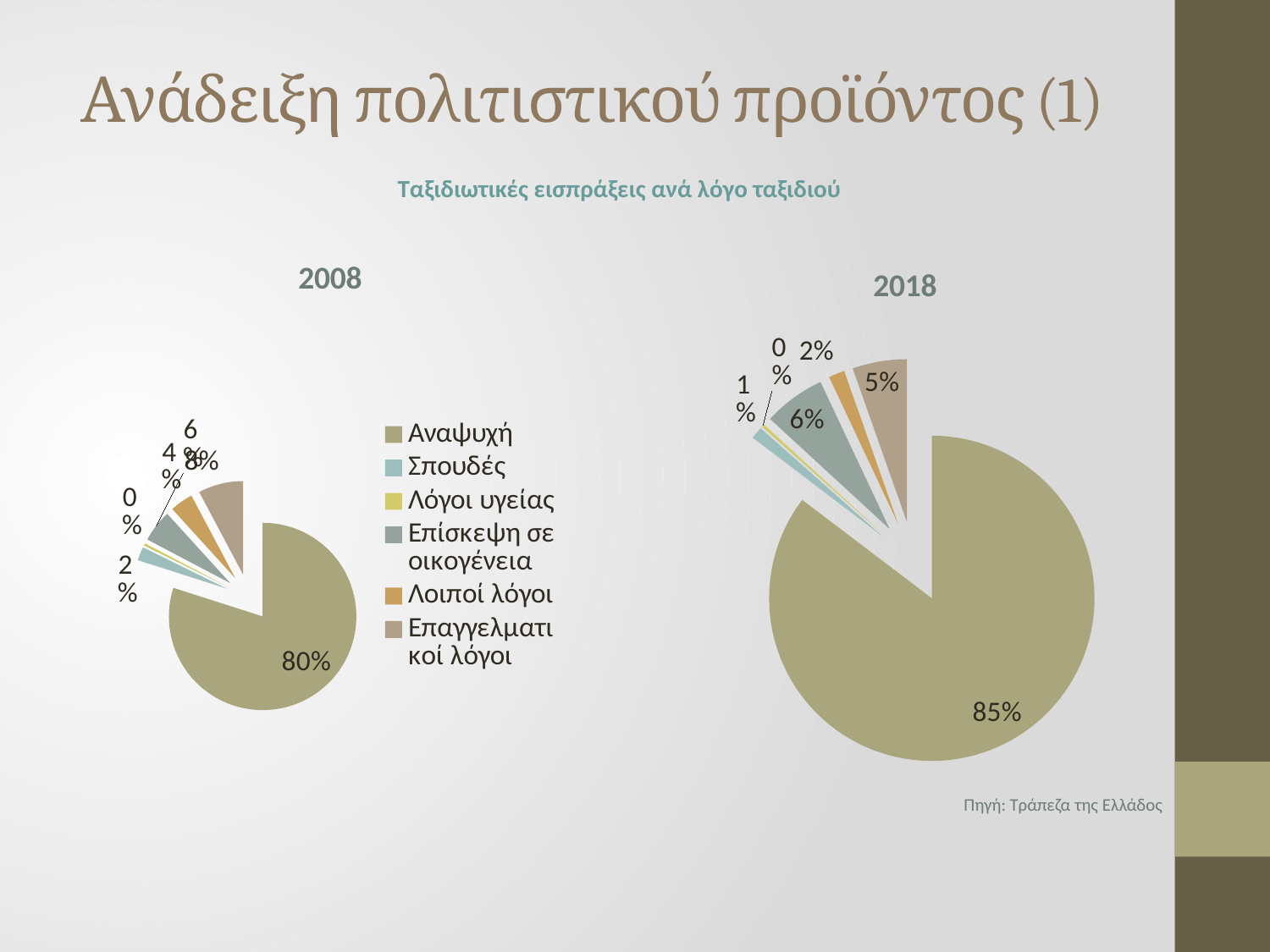
In the 2018 pie chart, what share does Επίσκεψη σε οικογένεια have? 6% In the 2018 pie chart, what share does Αναψυχή have? 85% In the 2018 pie chart, what share does Επαγγελματικοί λόγοι have? 5% In the 2018 pie chart, what share does Λοιποί λόγοι have? 2% In the 2008 pie chart, what share does Σπουδές have? 2% In the 2008 pie chart, what share does Αναψυχή have? 80% What is the source cited for the charts? Τράπεζα της Ελλάδος What type of charts are shown on the slide? Pie charts How many categories does the legend list? 6 In the 2008 pie chart, which category has the largest share? Αναψυχή In the 2018 pie chart, which category has the smallest share? Λόγοι υγείας How much larger is the Αναψυχή share in the 2018 pie chart than in the 2008 pie chart? 5 percentage points